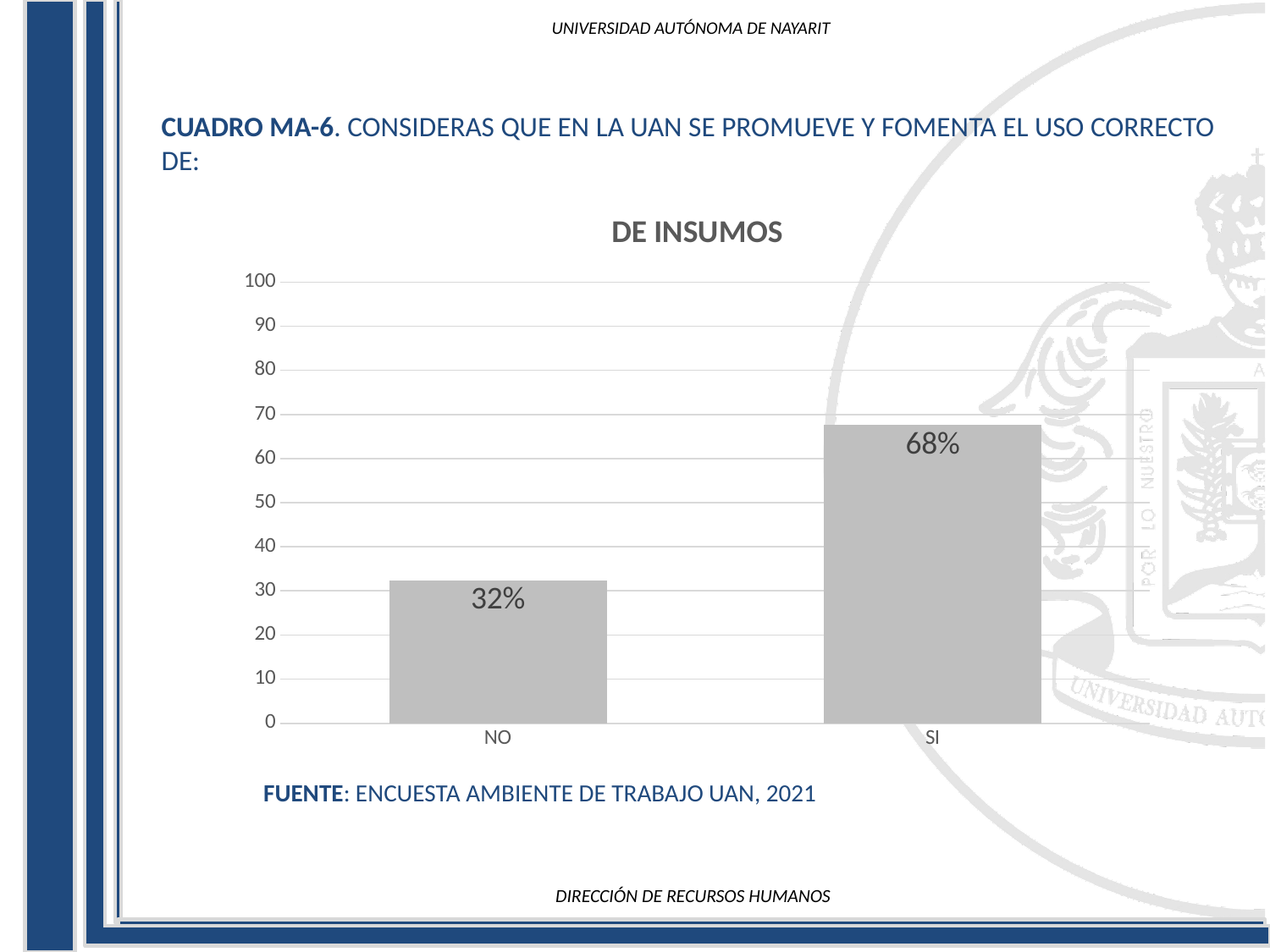
What is the value for SI? 68% Which category has the highest value? SI What is the highest value shown on the y axis? 100 Is the value for NO greater or less than 40? less Is the value for SI greater or less than 60? greater What is the title of the chart? DE INSUMOS What is the difference between the values for SI and NO? 36% How many categories are shown on the x axis? 2 What is the value for NO? 32% Which category has the lowest value? NO Which is larger, the value for NO or the value for SI? SI What kind of chart is shown? bar chart